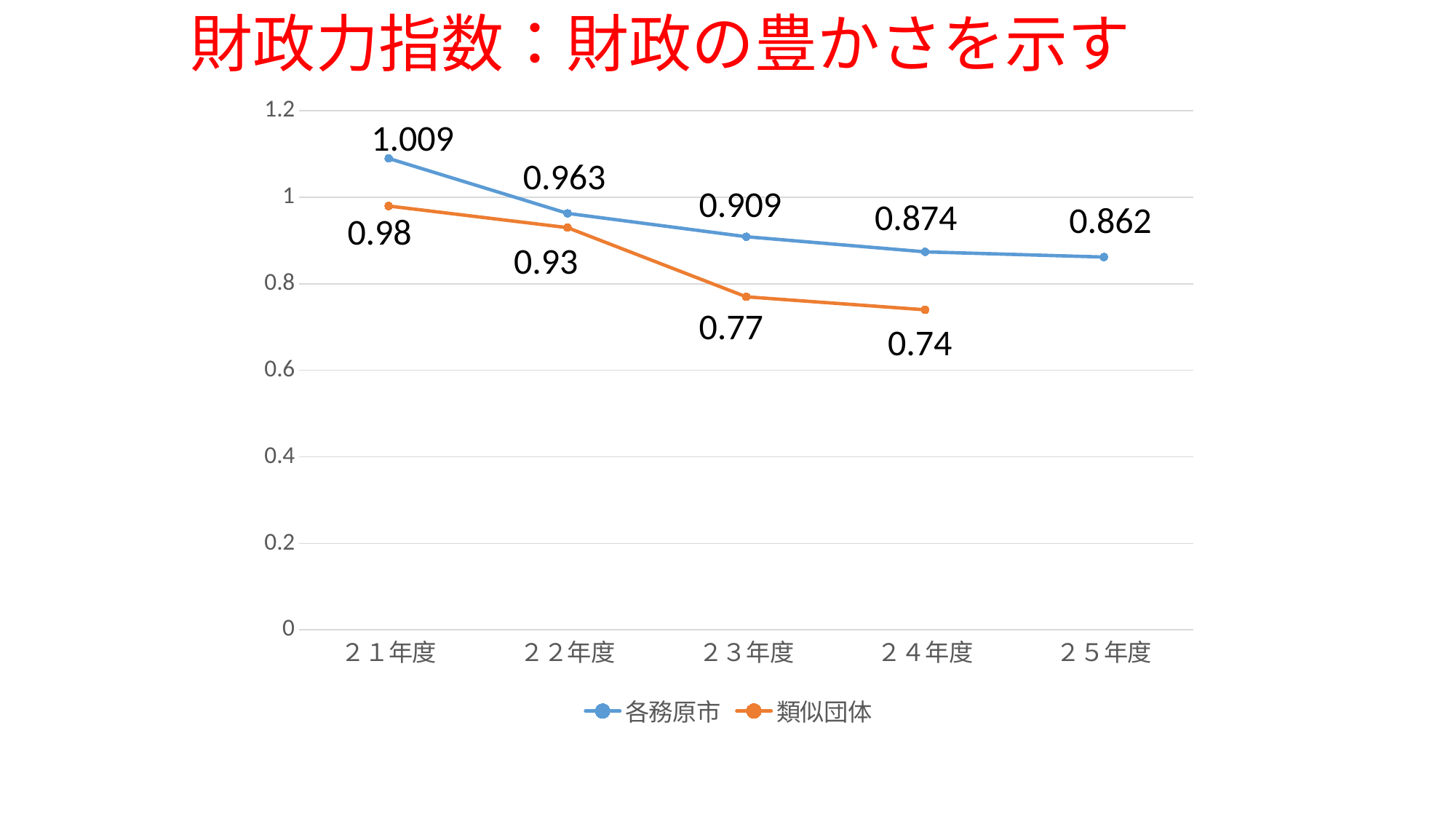
How many years are shown on the x axis? 5 Is the value for 類似団体 in ２３年度 greater or less than 0.8? less Do the values for 各務原市 rise or fall from ２１年度 to ２５年度? fall Which is larger in ２２年度, 各務原市 or 類似団体? 各務原市 What is the value for 各務原市 in ２５年度? 0.862 In which year does 類似団体 have its lowest value? ２４年度 How many series does the legend list? 2 In which year does 各務原市 have its highest value? ２１年度 What is the value for 各務原市 in ２１年度? 1.009 What is the difference between 各務原市 and 類似団体 in ２４年度? 0.134 What kind of chart is shown on the slide? line chart What is the value for 類似団体 in ２３年度? 0.77